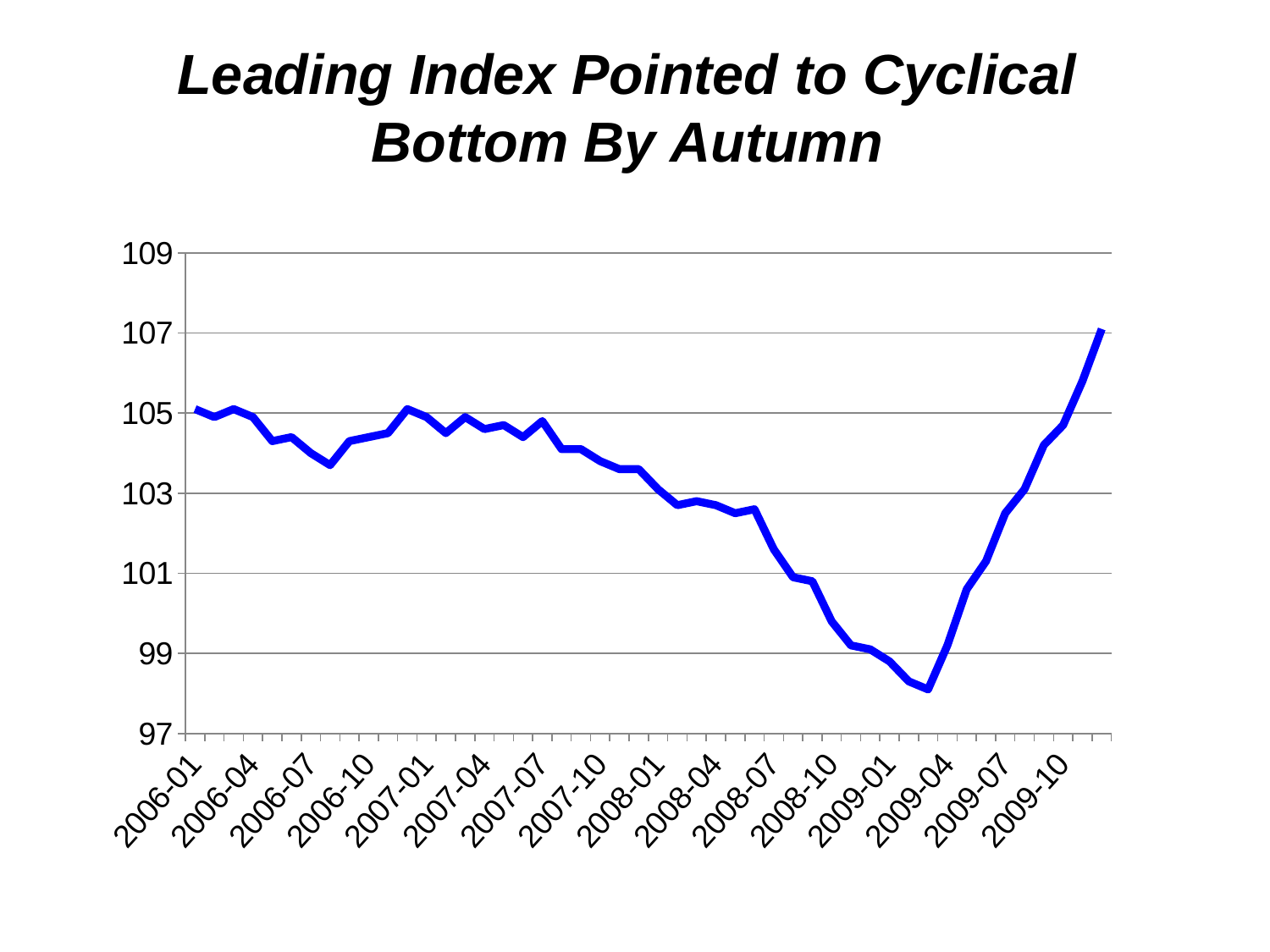
What is the title of the chart? Leading Index Pointed to Cyclical Bottom By Autumn How many month labels are shown on the x axis? 16 What kind of chart is shown on the slide? line chart Is the value for 2009-01 greater or less than 101? less Is the value for 2009-10 greater or less than 103? greater Is the value for 2008-01 greater or less than 105? less Does the index rise or fall between 2009-04 and 2009-10? rise Which labeled month on the x axis has the lowest value of the index? 2009-01 Which has the larger value, 2006-01 or 2009-04? 2006-01 Does the index rise or fall between 2008-07 and 2009-04? fall